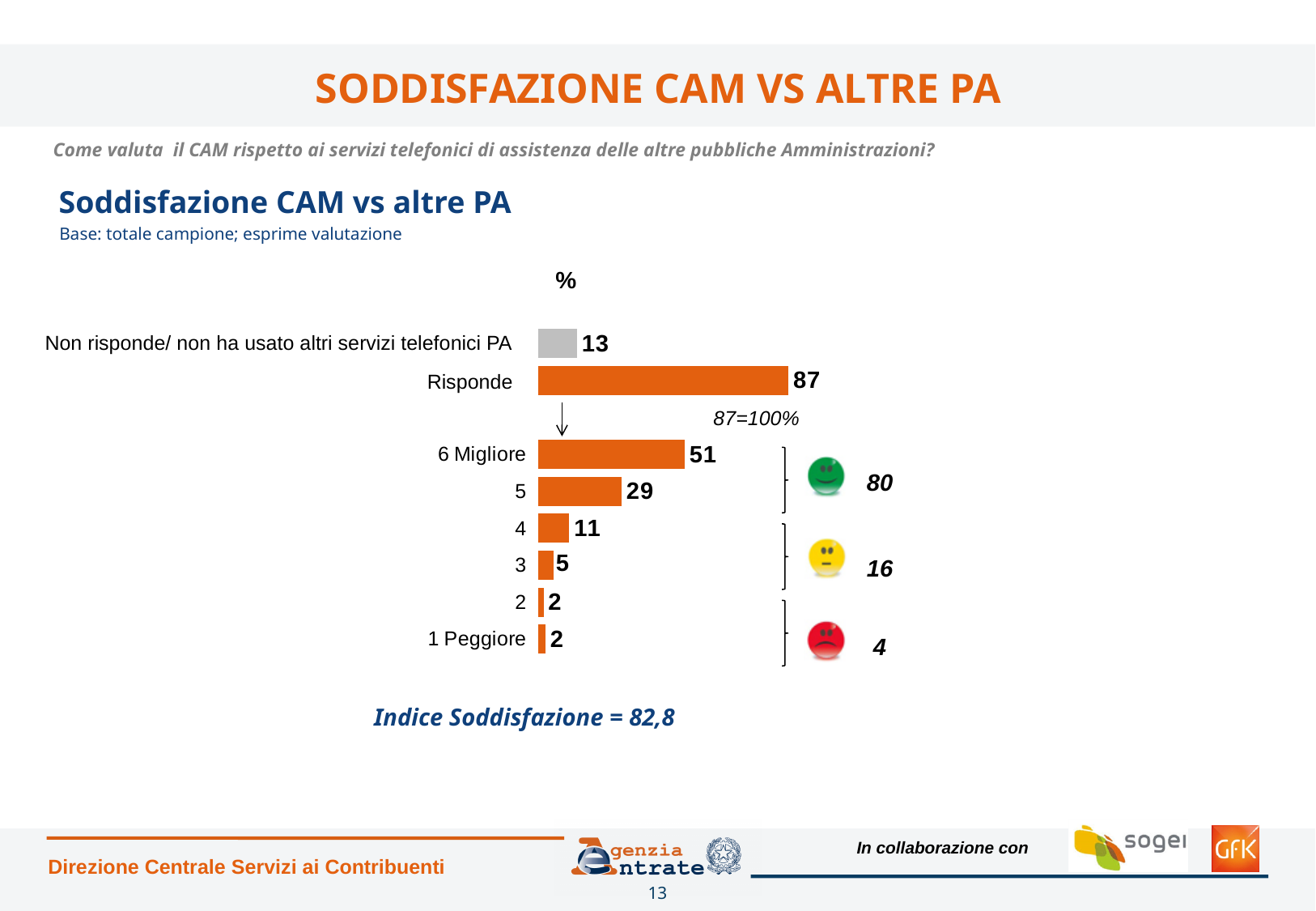
Which is larger, the value for "4" or the value for "3"? 4 What is the Indice Soddisfazione shown below the chart? 82,8 What is the difference between the values for "6 Migliore" and "5"? 22 What is the value for "6 Migliore"? 51 What is the value for "Non risponde/ non ha usato altri servizi telefonici PA"? 13 Among the ratings from "1 Peggiore" to "6 Migliore", which has the highest value? 6 Migliore What kind of chart is shown on the slide? bar chart What is the title of the chart? Soddisfazione CAM vs altre PA What is the combined value shown next to the red smiley for ratings 2 and 1? 4 What is the combined value shown next to the green smiley for ratings 6 and 5? 80 What is the value for rating "4"? 11 What is the value for "Risponde"? 87